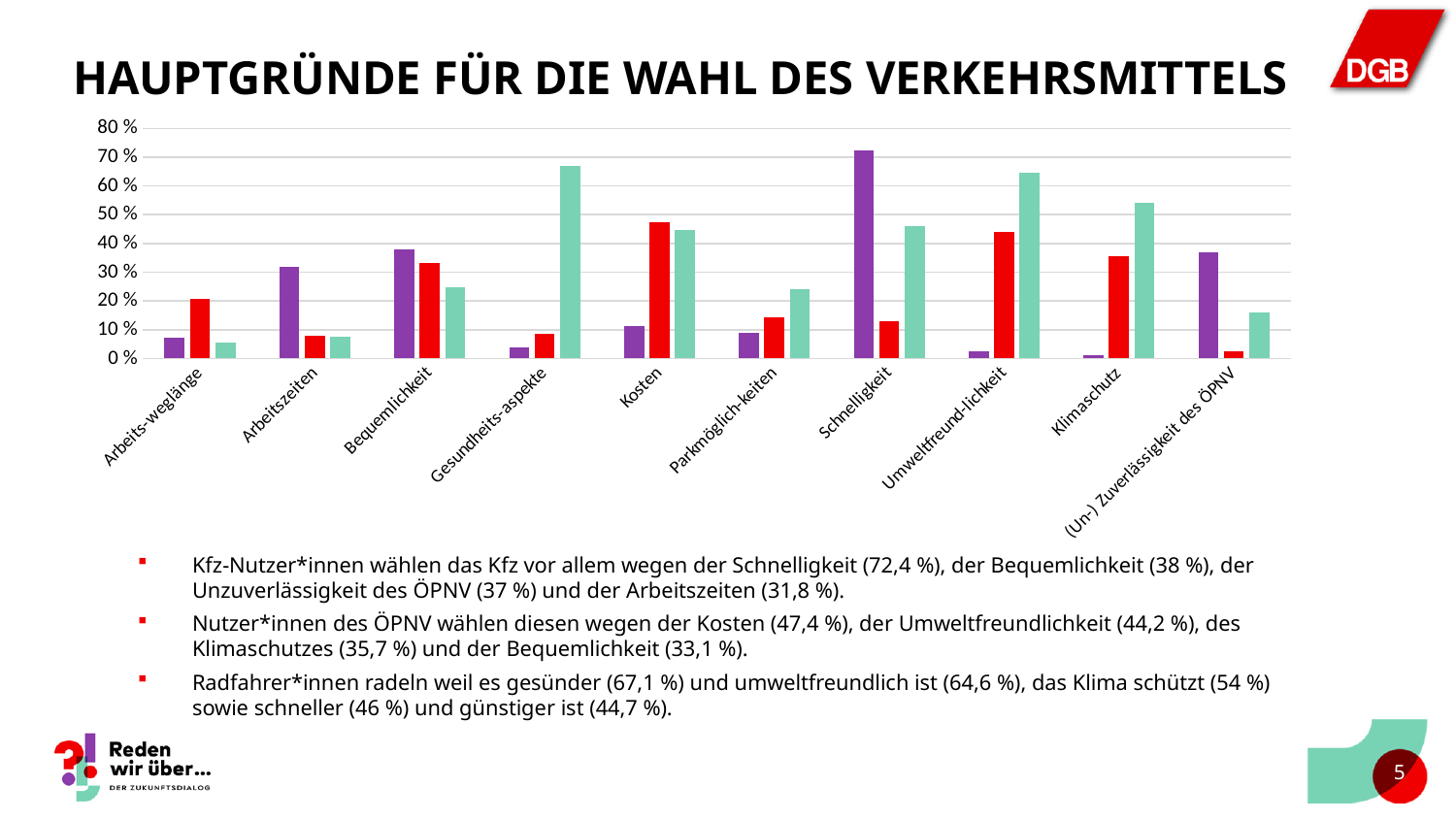
How many categories are shown on the x axis of the chart? 10 Is the green bar for Gesundheits-aspekte greater or less than 60 %? greater For Arbeitszeiten, which bar is taller, the purple bar or the red bar? the purple bar What is the highest value shown on the y axis of the chart? 80 % What kind of chart is shown on the slide? bar chart Is the green bar for (Un-) Zuverlässigkeit des ÖPNV greater or less than 20 %? less For Bequemlichkeit, which bar is taller, the red bar or the green bar? the red bar Is the purple bar for Schnelligkeit greater or less than 60 %? greater How many bars are shown for each category in the chart? 3 What is the title of the chart? HAUPTGRÜNDE FÜR DIE WAHL DES VERKEHRSMITTELS For which category is the purple bar the tallest? Schnelligkeit